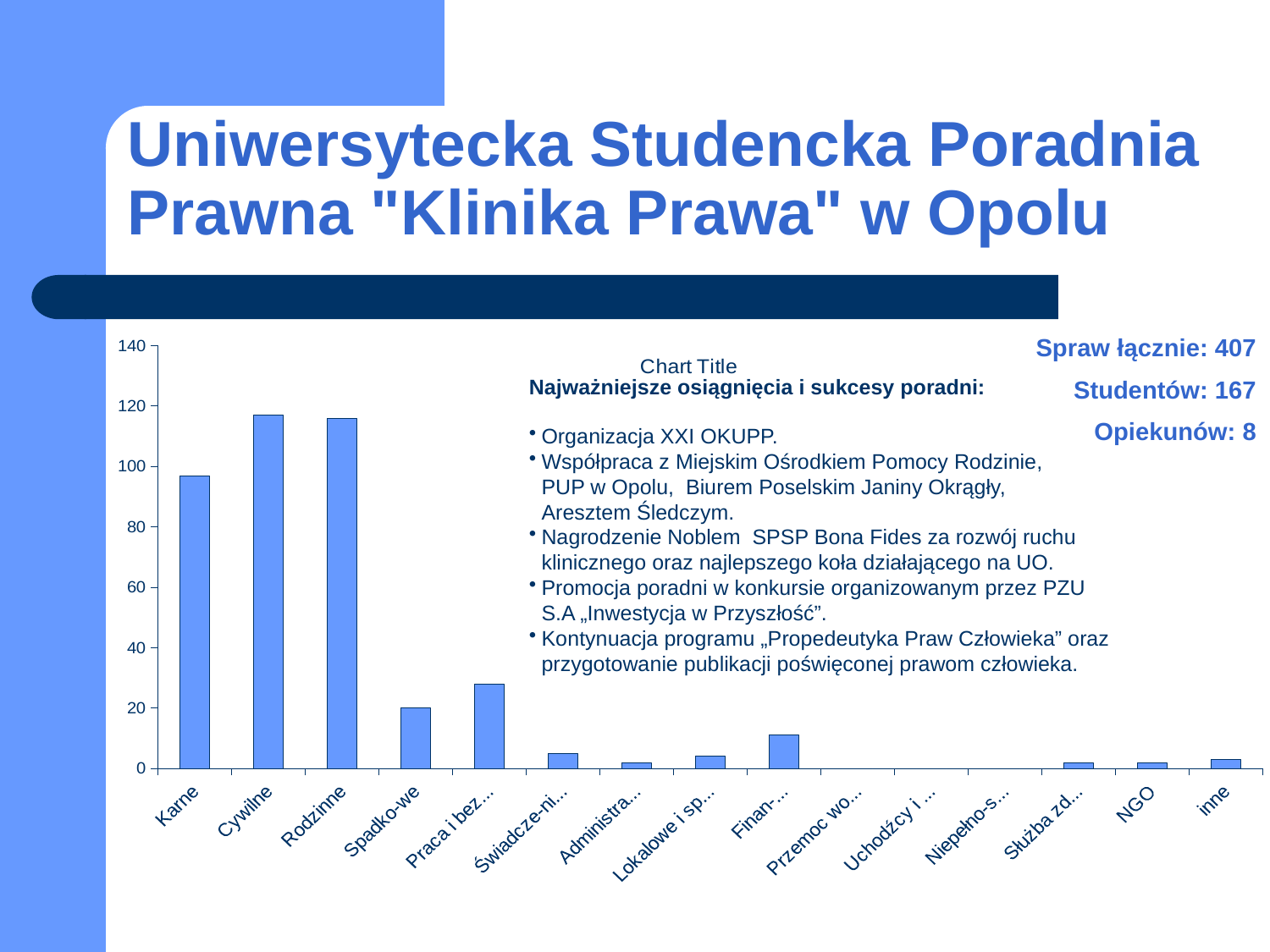
Is the value for Finan-... greater or less than 20? less Which is larger, the value for Karne or the value for Cywilne? Cywilne Is the value for Cywilne greater or less than 100? greater What kind of chart is shown on the slide? bar chart Is the value for Karne greater or less than 100? less Which is larger, the value for Spadko-we or the value for Praca i bez...? Praca i bez... What is the title printed on the chart? Chart Title How many categories are shown on the x axis of the chart? 15 Which is larger, the value for Rodzinne or the value for Spadko-we? Rodzinne